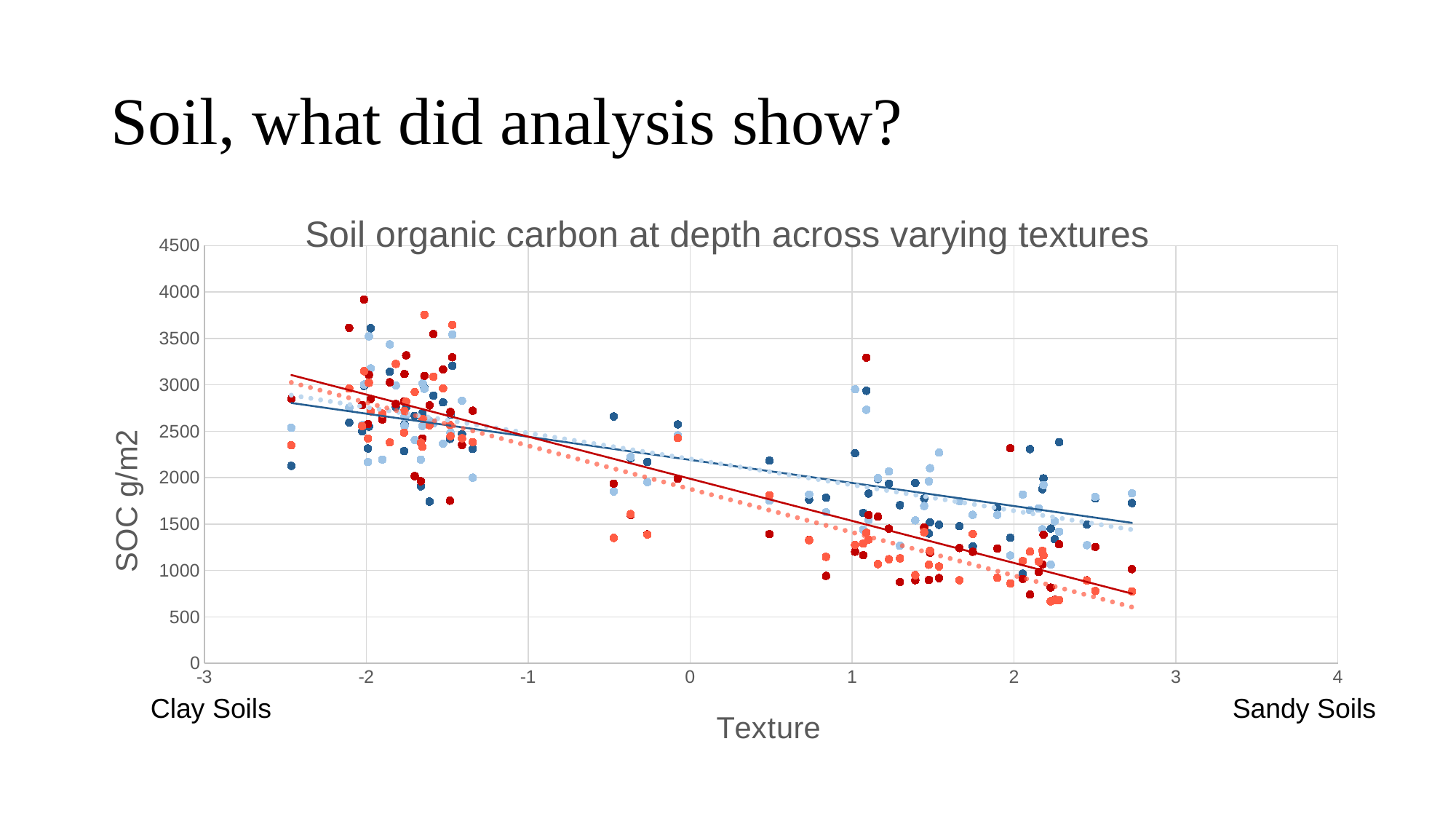
Is the value of the solid red trend line at texture -2 greater or less than 2500? greater Is the value of the solid blue trend line at texture 2 greater or less than 1500? greater What kind of chart is shown on the slide? Scatter chart What is the highest value shown on the y axis of the chart? 4500 At texture 2, which solid trend line is higher, the blue one or the red one? The blue one Is the highest plotted point on the chart greater or less than 3500? greater What are the labels of the y axis and the x axis of the chart? SOC g/m2 and Texture As texture moves from clay soils to sandy soils along the x axis, do the SOC values rise or fall? Fall At texture -2, which solid trend line is higher, the blue one or the red one? The red one What is the title of the chart? Soil organic carbon at depth across varying textures